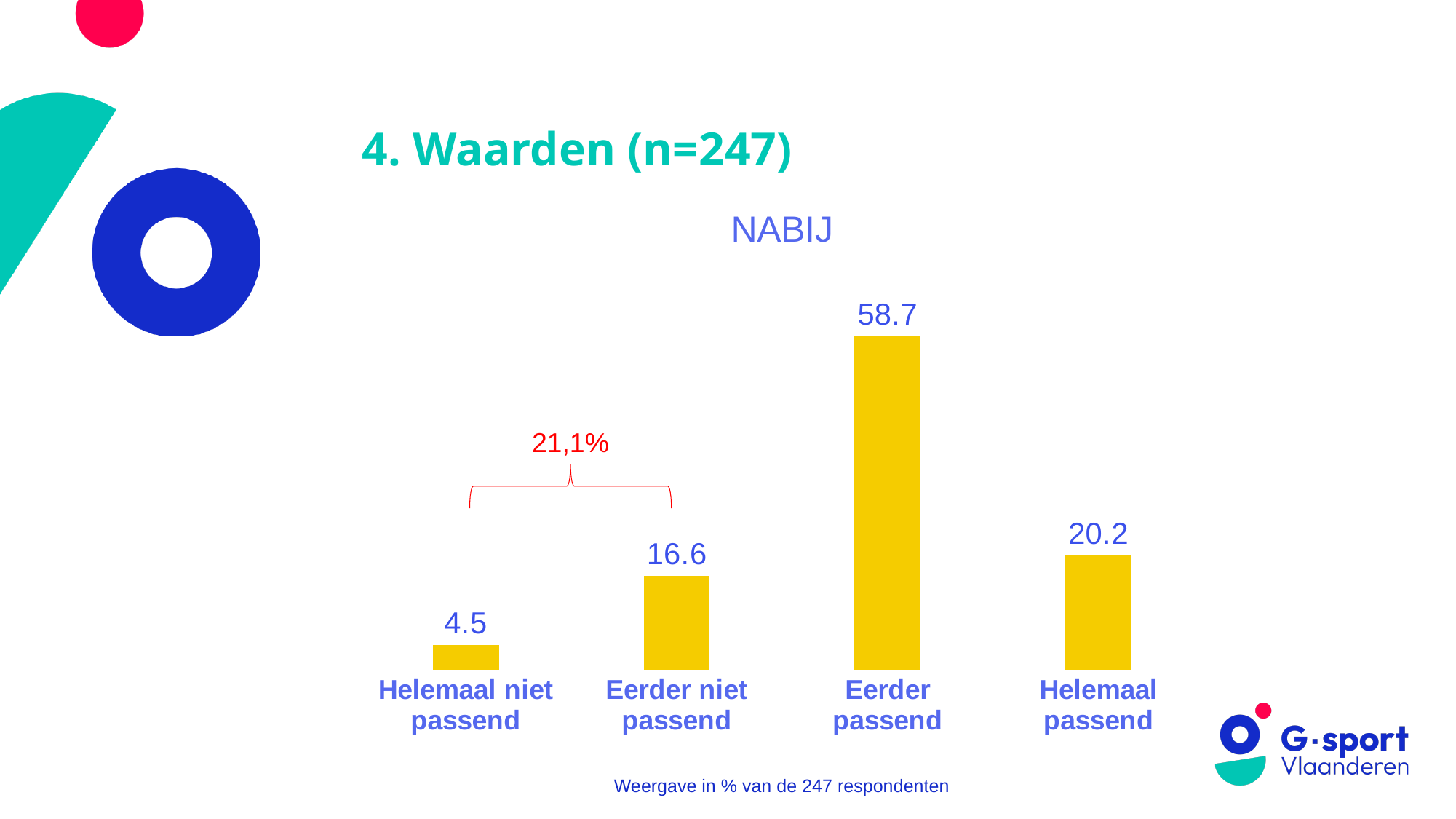
What is the value for 'Eerder passend'? 58.7 What is the value for 'Eerder niet passend'? 16.6 Which is larger, the value for 'Helemaal passend' or the value for 'Eerder niet passend'? Helemaal passend What is the value for 'Helemaal passend'? 20.2 Which category has the highest value? Eerder passend What kind of chart is shown on the slide? Bar chart How many categories are shown in the chart? 4 What is the title of the chart? NABIJ What is the difference between the values for 'Eerder passend' and 'Helemaal passend'? 38.5 What is the value for 'Helemaal niet passend'? 4.5 What is the difference between the values for 'Eerder niet passend' and 'Helemaal niet passend'? 12.1 Which category has the lowest value? Helemaal niet passend